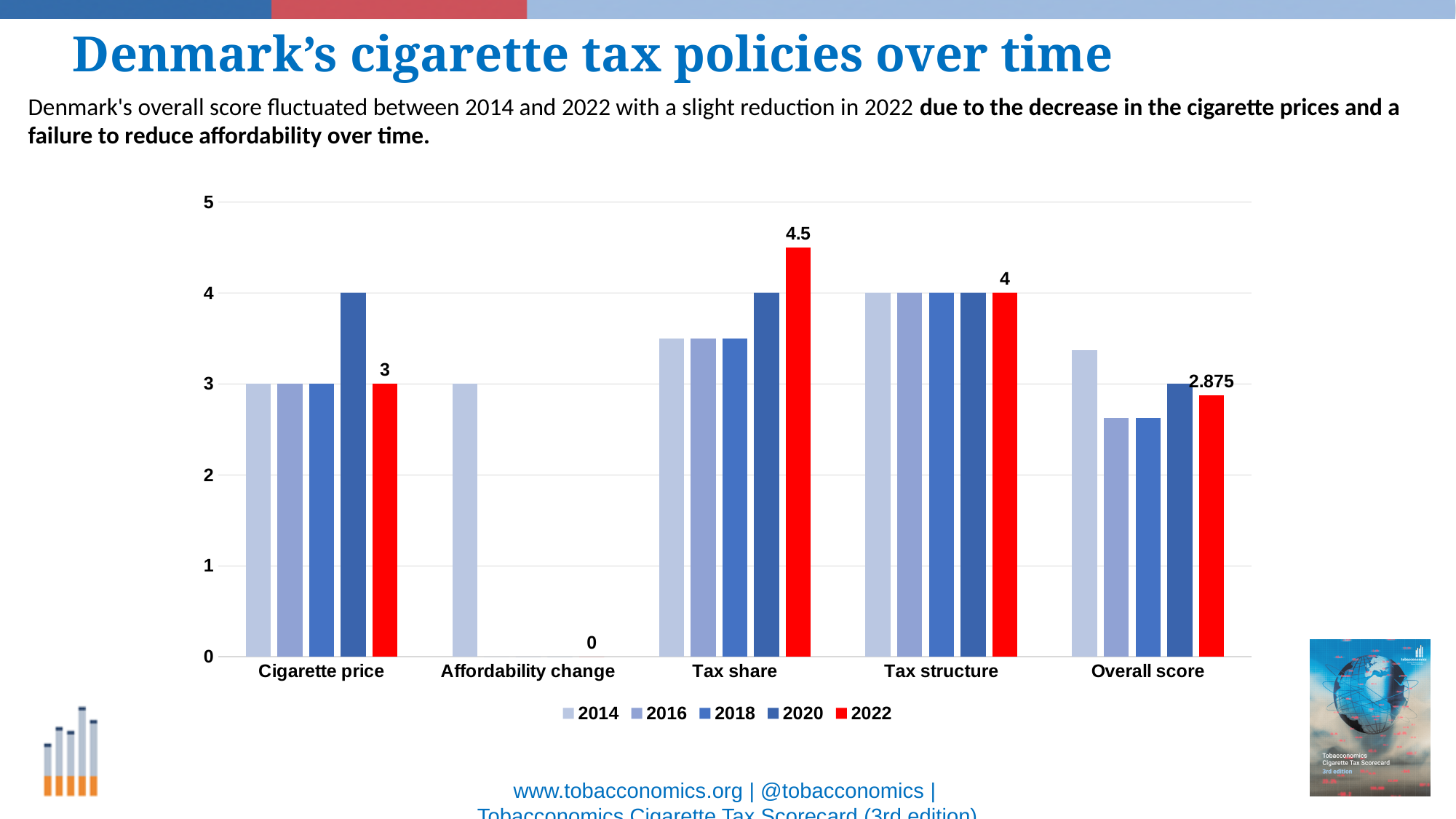
Among the 2022 bars, which category has the highest value? Tax share What kind of chart is shown on the slide? bar chart How many categories are shown on the x axis? 5 What is the difference between the 2022 Tax share value and the 2022 Overall score value? 1.625 What is the 2022 value for Overall score? 2.875 What is the 2022 value for Affordability change? 0 What is the 2022 value for Tax share? 4.5 How many series does the legend list? 5 Is the 2014 value for Overall score greater or less than 3? greater Among the 2022 bars, which category has the lowest value? Affordability change Do the Tax share values rise or fall from 2014 to 2022? rise In 2022, which is larger: the Tax share value or the Tax structure value? Tax share